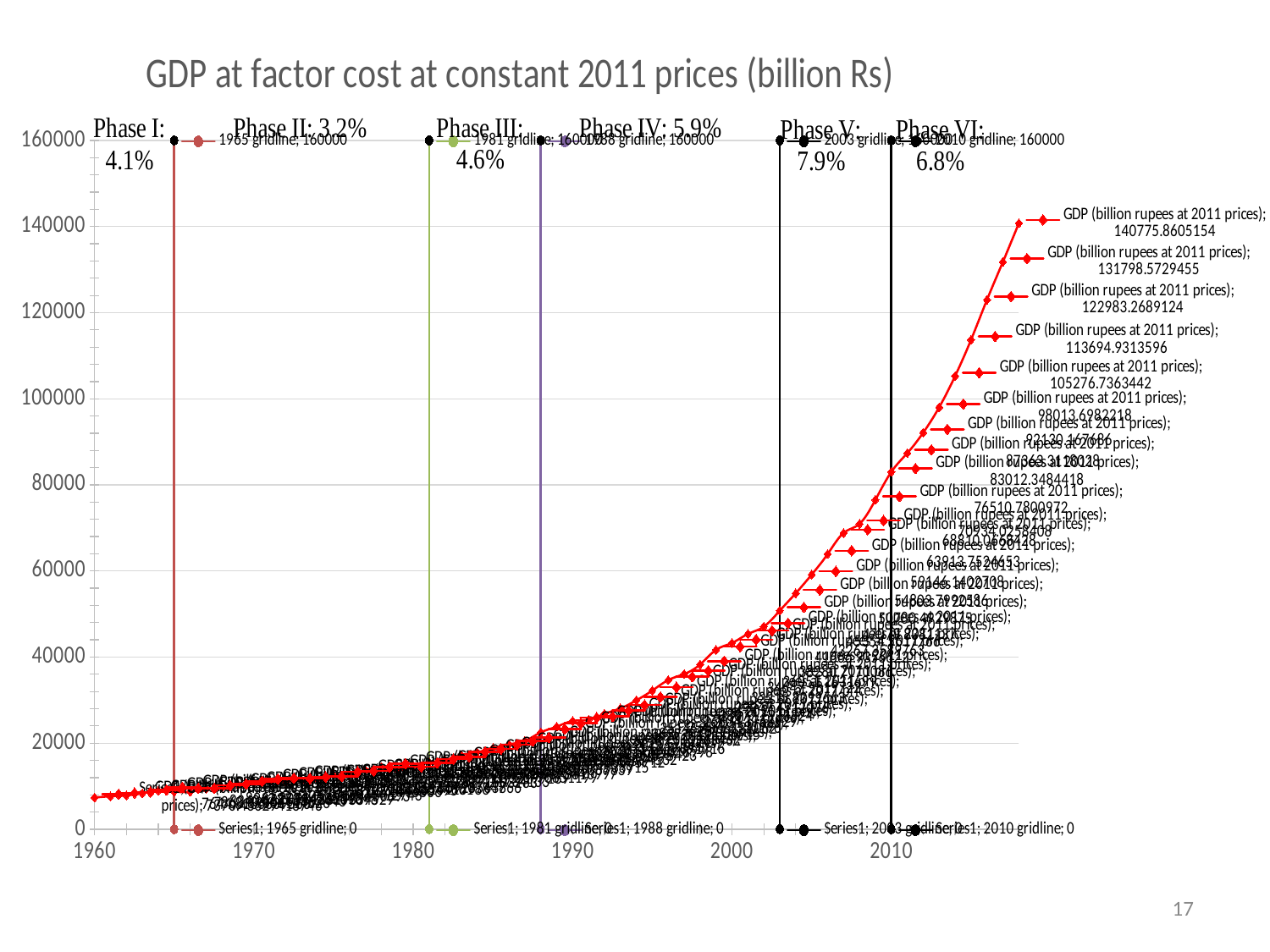
What is the maximum value shown on the y axis? 160000 What is the second-highest GDP value labelled on the chart? 131798.5729455 What is the title of the chart? GDP at factor cost at constant 2011 prices (billion Rs) What is the difference between the two highest labelled GDP values, 140775.8605154 and 131798.5729455? 8977.2875699 Is the GDP value for 1980 greater or less than 20000? less Which phase has the highest annotated growth rate? Phase V Is the GDP value for 1990 greater or less than 20000? greater What kind of chart is shown on the slide? Line chart Which phase has the lowest annotated growth rate? Phase II What is the highest GDP value labelled on the chart? 140775.8605154 Does GDP rise or fall over time along the x axis? Rises What growth rate is annotated for Phase V? 7.9%